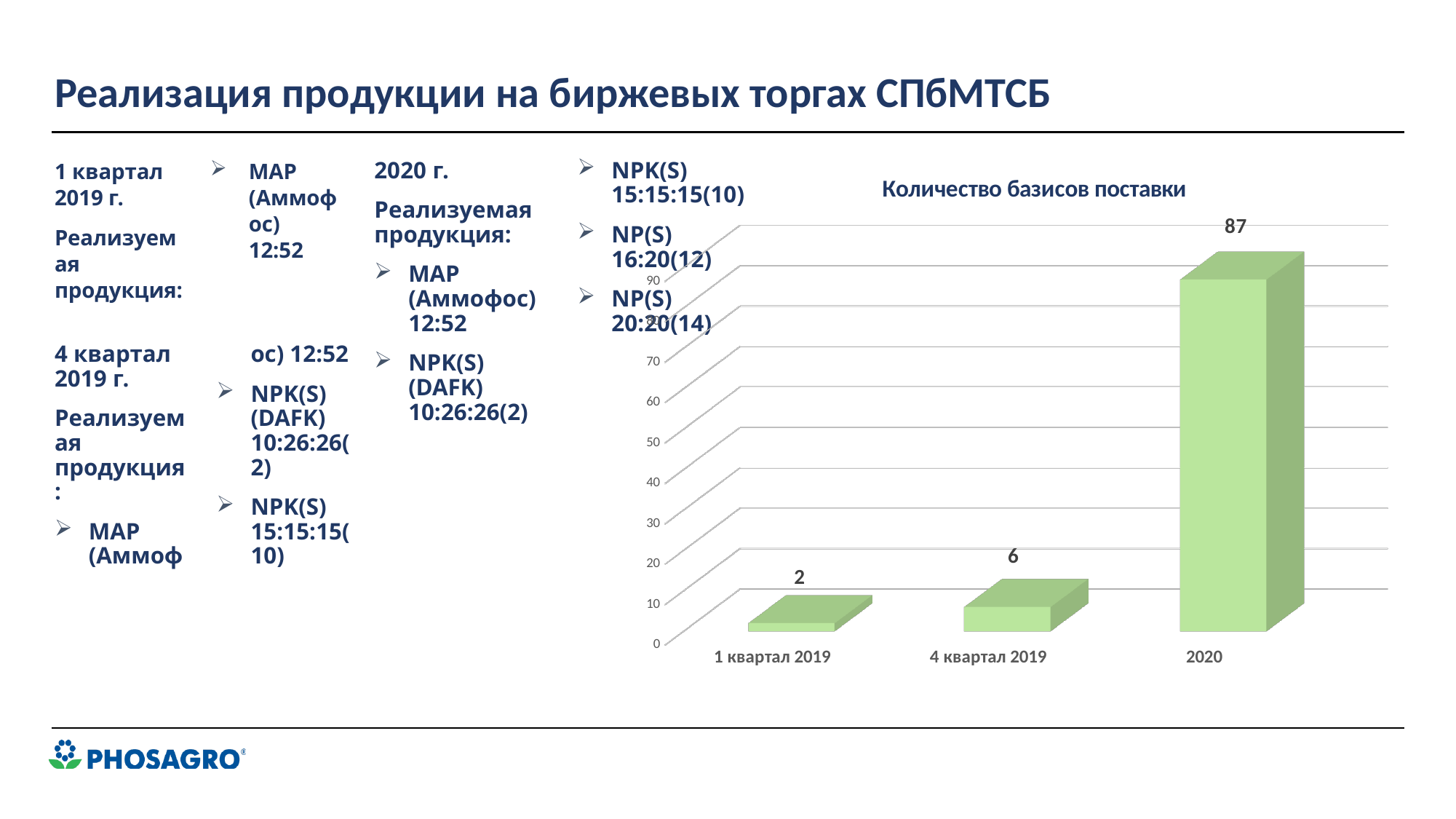
What kind of chart is shown on the slide? bar chart What is the title of the chart? Количество базисов поставки How many categories are shown on the x axis of the chart? 3 Which is larger, the value for 4 квартал 2019 or the value for 1 квартал 2019? 4 квартал 2019 What is the difference between the values for 2020 and 4 квартал 2019? 81 What is the value for 2020 in the chart? 87 What is the difference between the values for 4 квартал 2019 and 1 квартал 2019? 4 Which category has the highest value? 2020 Is the value for 2020 greater or less than 80? greater Which category has the lowest value? 1 квартал 2019 What is the value for 4 квартал 2019? 6 What is the value for 1 квартал 2019? 2